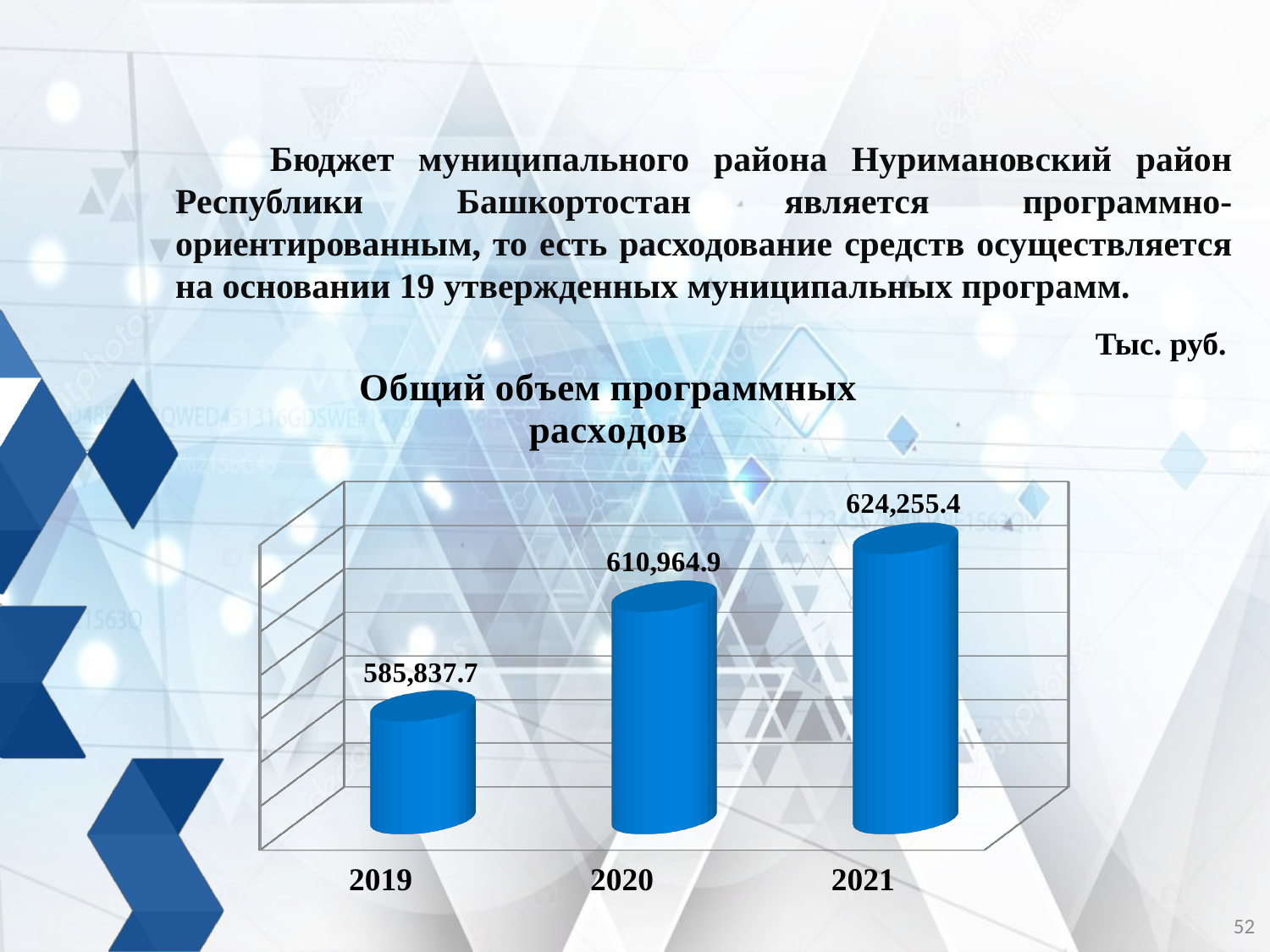
What is the value for 2019 in the chart? 585,837.7 What is the value for 2020 in the chart? 610,964.9 What is the difference between the values for 2021 and 2020? 13,290.5 What is the difference between the values for 2020 and 2019? 25,127.2 What kind of chart is shown on the slide? Bar chart Do the values rise or fall from 2019 to 2021? Rise How many years are shown in the chart? 3 Which year has the highest value in the chart? 2021 What is the difference between the values for 2021 and 2019? 38,417.7 What is the value for 2021 in the chart? 624,255.4 Which year has the lowest value in the chart? 2019 Which is larger, the value for 2019 or the value for 2021? 2021